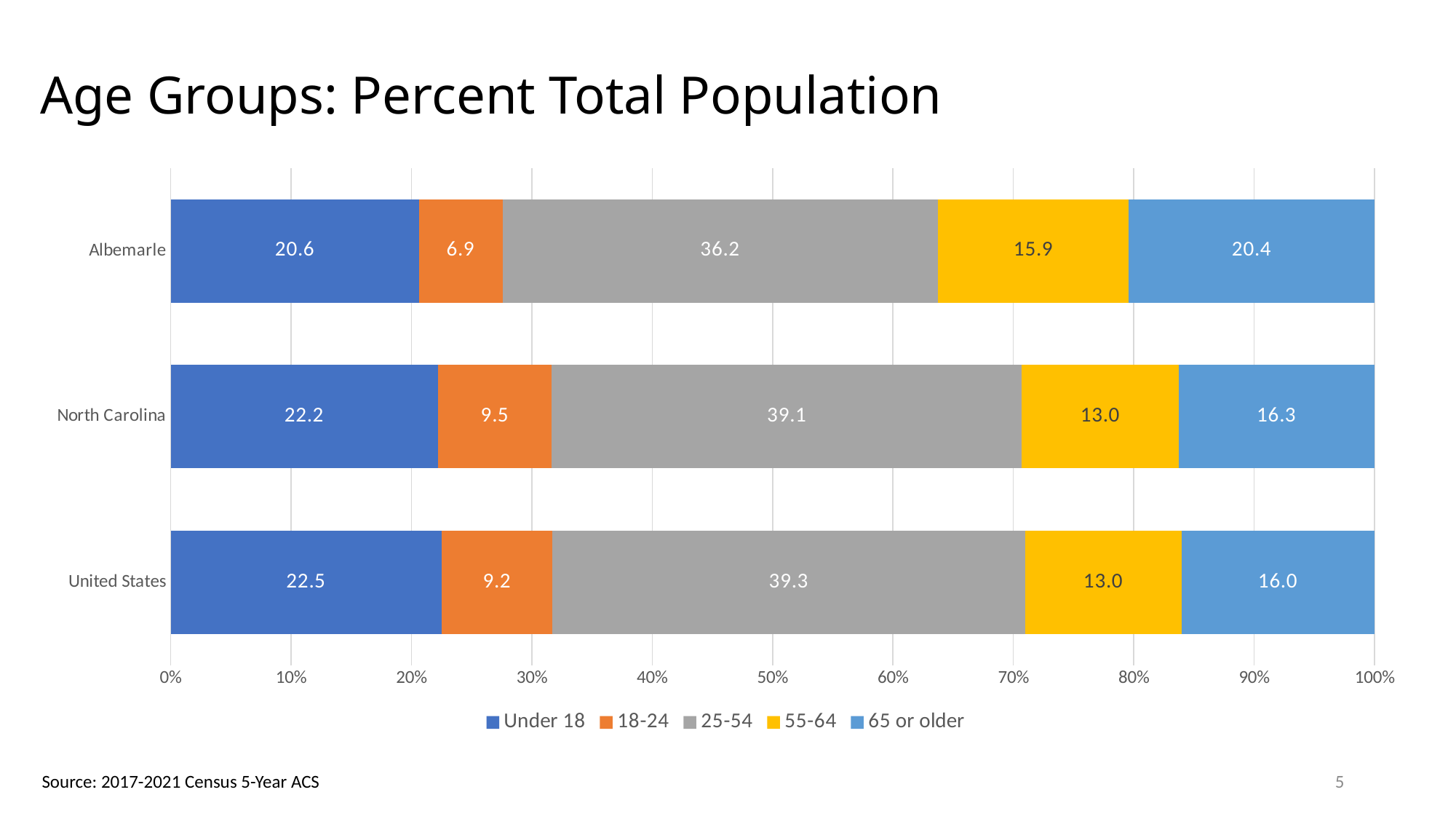
What is the value for the 65 or older age group in North Carolina? 16.3 Which region has the highest value for the 65 or older age group? Albemarle How many series does the legend list? 5 Which region has the lowest value for the 18-24 age group? Albemarle Which is larger, the 55-64 value for Albemarle or for North Carolina? Albemarle What is the difference between the Under 18 values for the United States and Albemarle? 1.9 What kind of chart is shown on the slide? Stacked bar chart How many regions are shown on the chart? 3 What is the value for the 18-24 age group in the United States? 9.2 What is the source cited for the chart data? 2017-2021 Census 5-Year ACS What is the value for the 25-54 age group in Albemarle? 36.2 What is the title of the chart? Age Groups: Percent Total Population